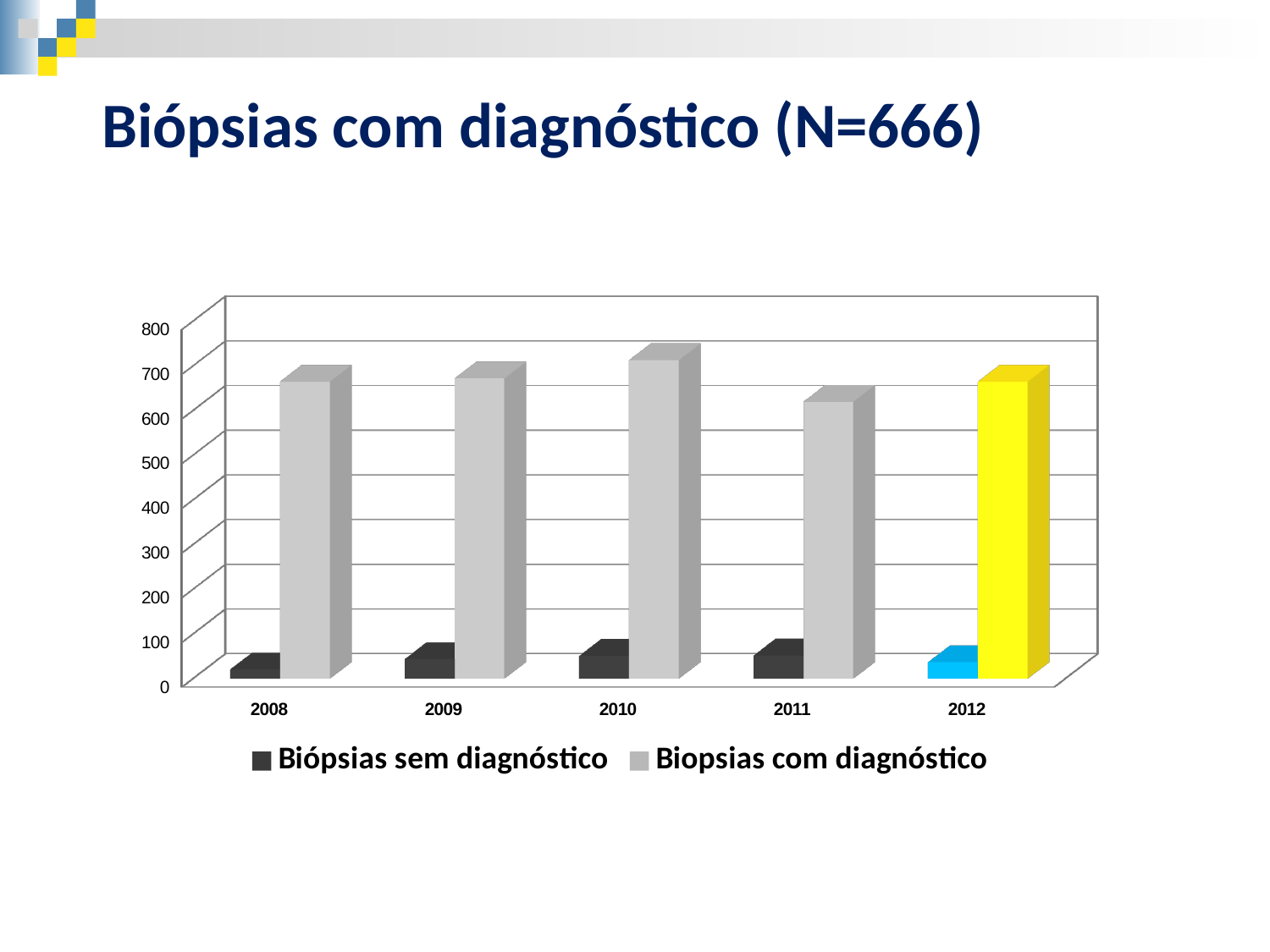
How many series does the legend list? 2 Which year's bars are drawn in different colours (blue and yellow) from the other years? 2012 Which is larger, Biopsias com diagnóstico in 2010 or in 2011? 2010 Which year has the highest value for Biopsias com diagnóstico? 2010 Is the value for Biopsias com diagnóstico in 2011 greater or less than 700? less How many years are shown on the x axis? 5 Is the value for Biopsias com diagnóstico in 2010 greater or less than 600? greater What is the title of the slide's chart? Biópsias com diagnóstico (N=666) Which year has the lowest value for Biopsias com diagnóstico? 2011 Is the value for Biópsias sem diagnóstico in 2011 greater or less than 100? less What kind of chart is shown on the slide? bar chart Which is larger, Biópsias sem diagnóstico in 2008 or in 2011? 2011